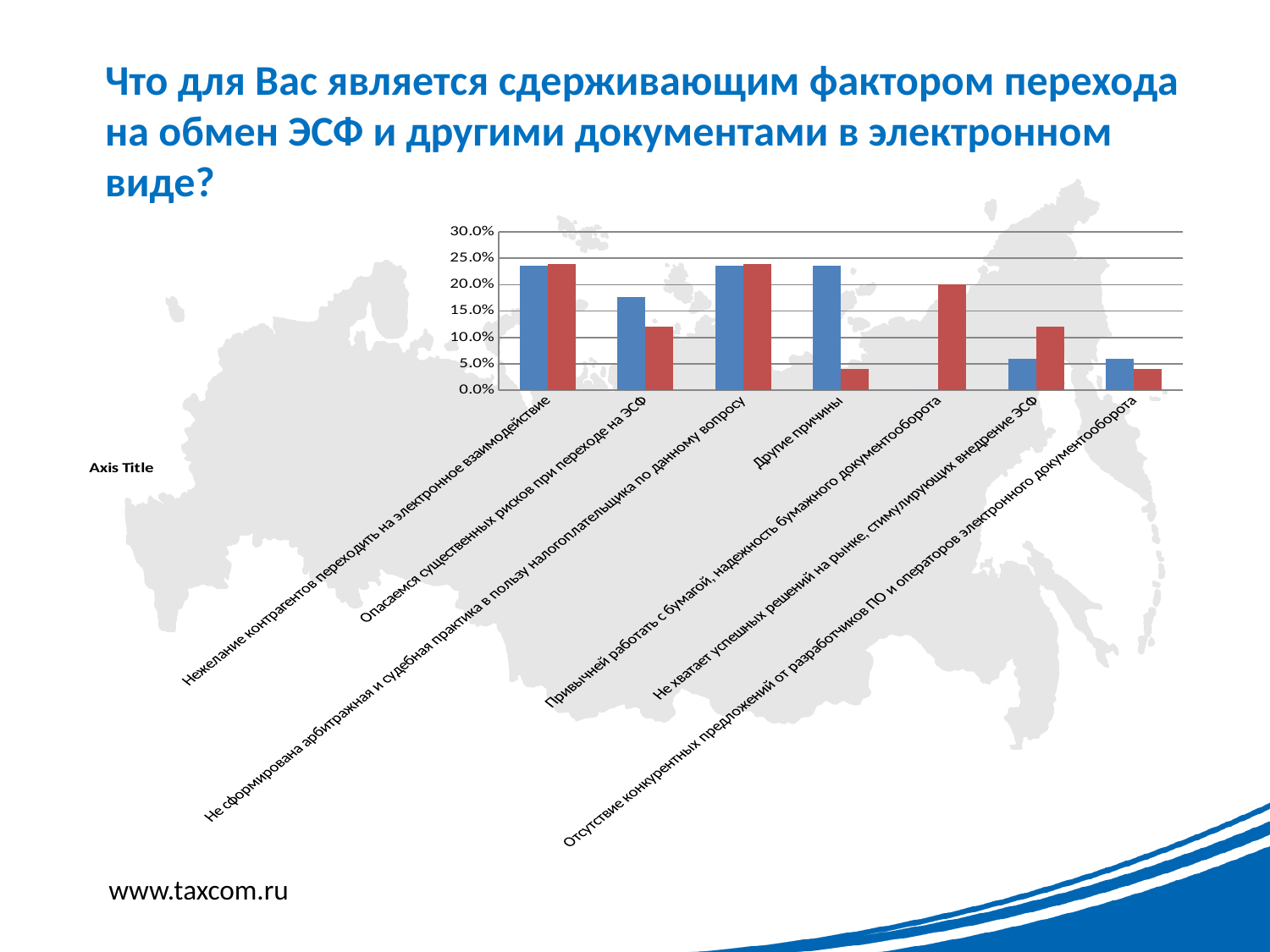
How many categories are shown on the x axis of the chart? 7 Is the red bar for 'Другие причины' greater or less than 10.0%? less Which category has no visible blue bar at all? Привычней работать с бумагой, надежность бумажного документооборота For the category 'Опасаемся существенных рисков при переходе на ЭСФ', which bar is taller, the blue one or the red one? the blue one For the category 'Другие причины', which bar is taller, the blue one or the red one? the blue one What kind of chart is shown on the slide? bar chart Is the blue bar for 'Нежелание контрагентов переходить на электронное взаимодействие' greater or less than 20.0%? greater What is the highest value shown on the chart's vertical axis? 30.0% Is the red bar for 'Привычней работать с бумагой, надежность бумажного документооборота' greater or less than 15.0%? greater For the category 'Не хватает успешных решений на рынке, стимулирующих внедрение ЭСФ', which bar is taller, the blue one or the red one? the red one What text is shown as the axis title on the chart? Axis Title